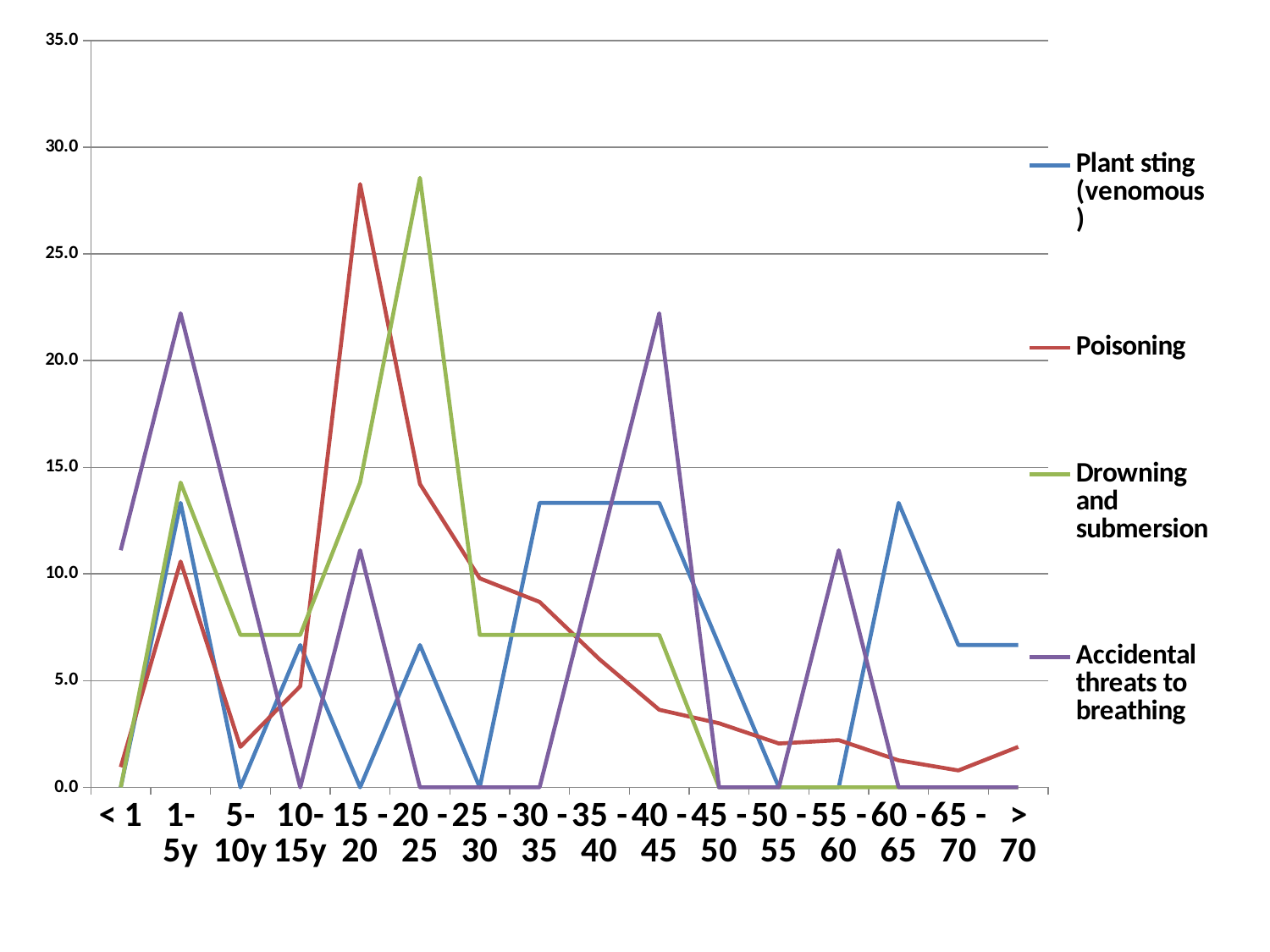
What kind of chart is shown on the slide? line chart How many age categories are shown along the x axis? 16 Which series reaches the highest value in the 15-20 age group? Poisoning Is the value for Poisoning in the 15-20 age group greater or less than 25.0? greater What is the value for Drowning and submersion in the 50-55 age group? 0.0 How many series does the legend list? 4 Which is larger in the 40-45 age group, Accidental threats to breathing or Poisoning? Accidental threats to breathing Does the Poisoning line rise or fall from the 15-20 age group to the 50-55 age group? fall Which colour is used for the Drowning and submersion line? green Is the value for Accidental threats to breathing in the 1-5y age group greater or less than 20.0? greater What is the value for Plant sting (venomous) in the 5-10y age group? 0.0 Which series reaches the highest value in the 20-25 age group? Drowning and submersion